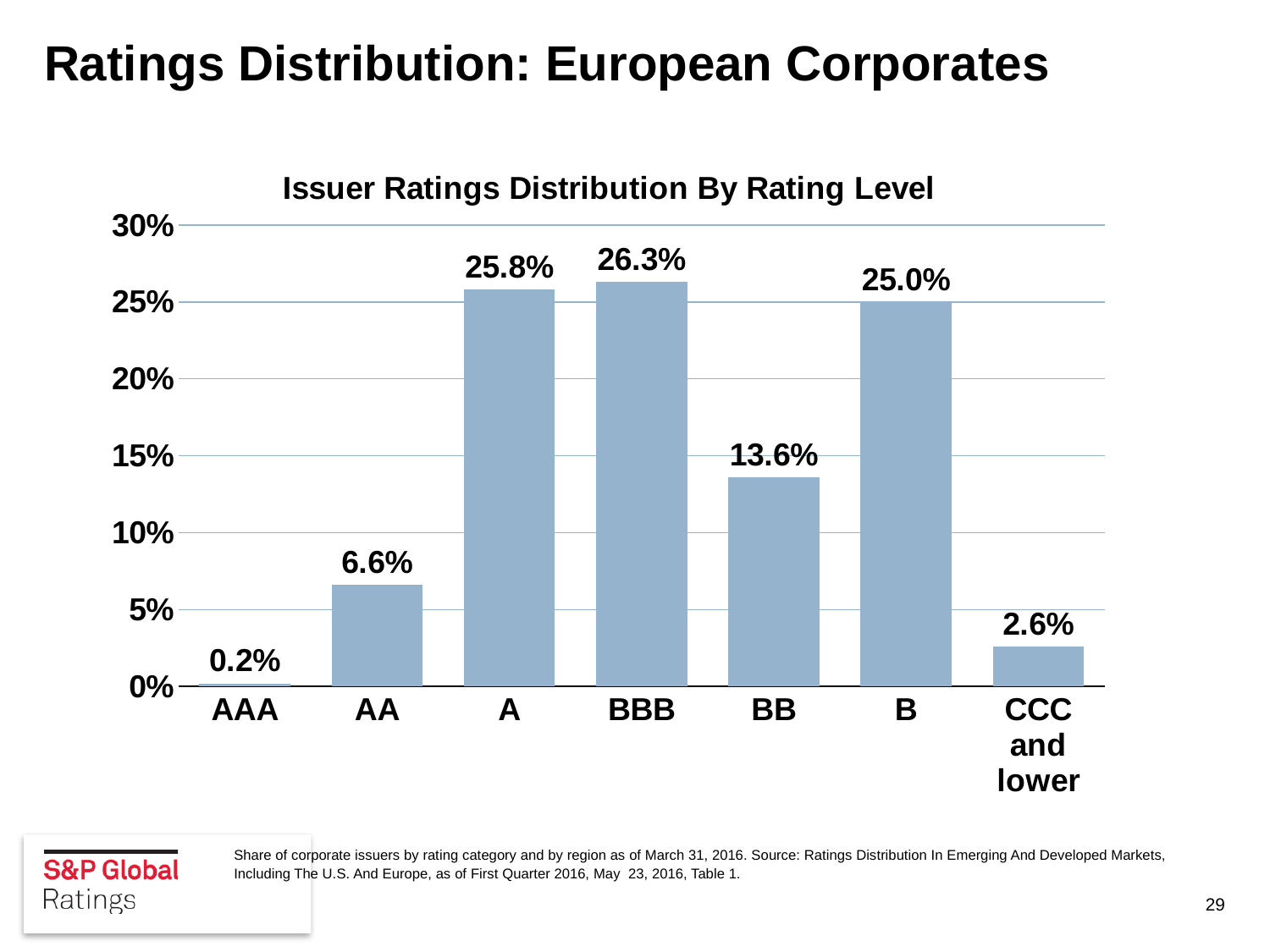
What is the value for the BBB rating category? 26.3% Which rating category has the highest share of issuers? BBB What is the value for the AA rating category? 6.6% What is the difference between the values for A and BB? 12.2% What kind of chart is shown on the slide? bar chart Which rating category has the lowest share of issuers? AAA How many rating categories are shown on the x axis? 7 What is the value for the CCC and lower rating category? 2.6% Is the value for BB greater or less than 15%? less What is the title of the chart? Issuer Ratings Distribution By Rating Level Which is larger, the value for B or the value for BB? B What is the difference between the values for BBB and A? 0.5%